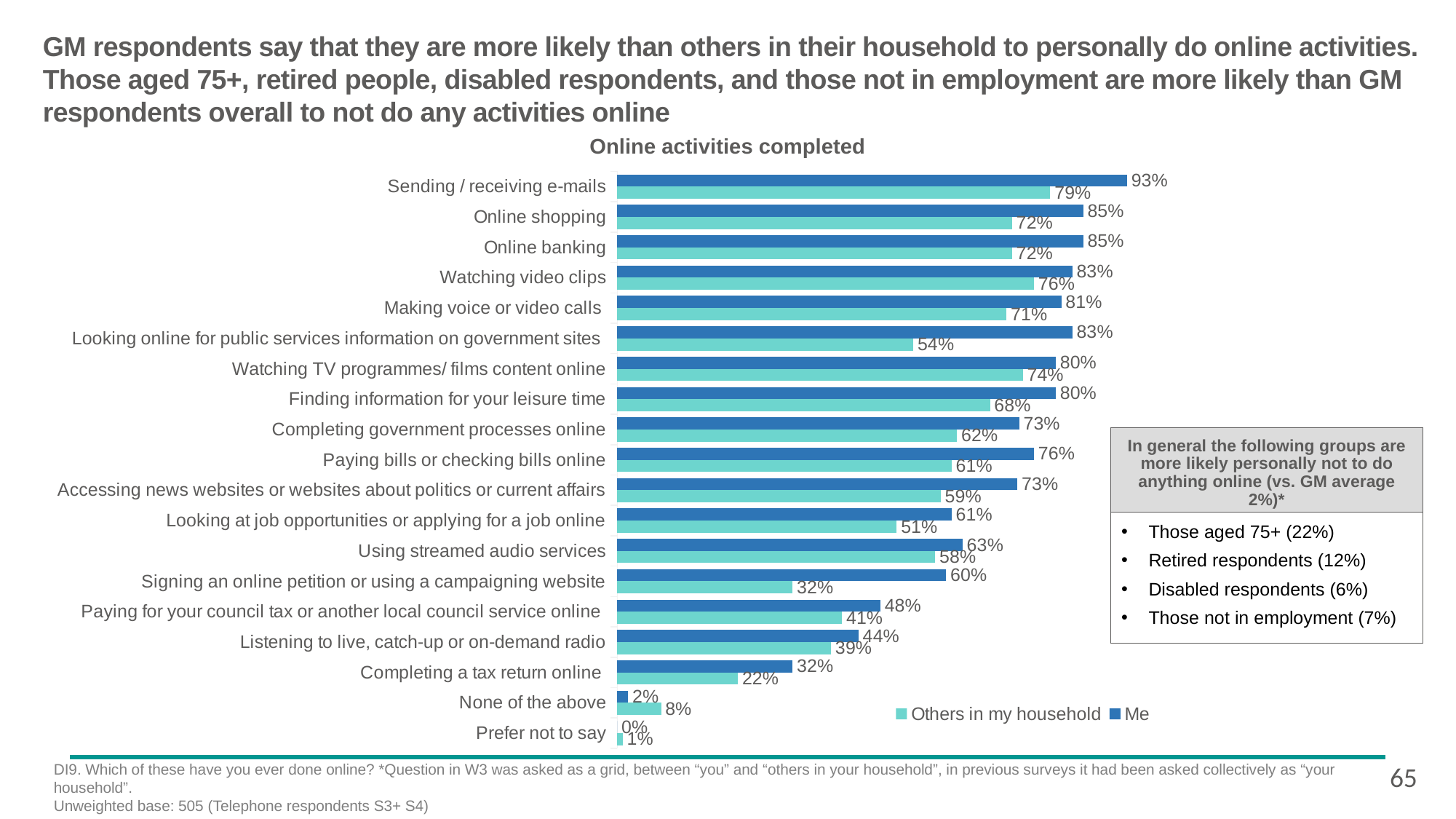
How many categories are shown on the chart? 19 What kind of chart is shown on the slide? Bar chart What is the difference between the "Me" and "Others in my household" values for Signing an online petition or using a campaigning website? 28% For None of the above, which is larger: the "Me" value or the "Others in my household" value? Others in my household What is the value for "Me" for Completing a tax return online? 32% Which activity has the highest value for "Me"? Sending / receiving e-mails What is the value for "Others in my household" for Listening to live, catch-up or on-demand radio? 39% Which category has the lowest value for "Others in my household"? Prefer not to say How many series does the legend list? 2 What is the value for "Others in my household" for Looking online for public services information on government sites? 54% What is the title of the chart? Online activities completed What is the value for "Me" for Sending / receiving e-mails? 93%